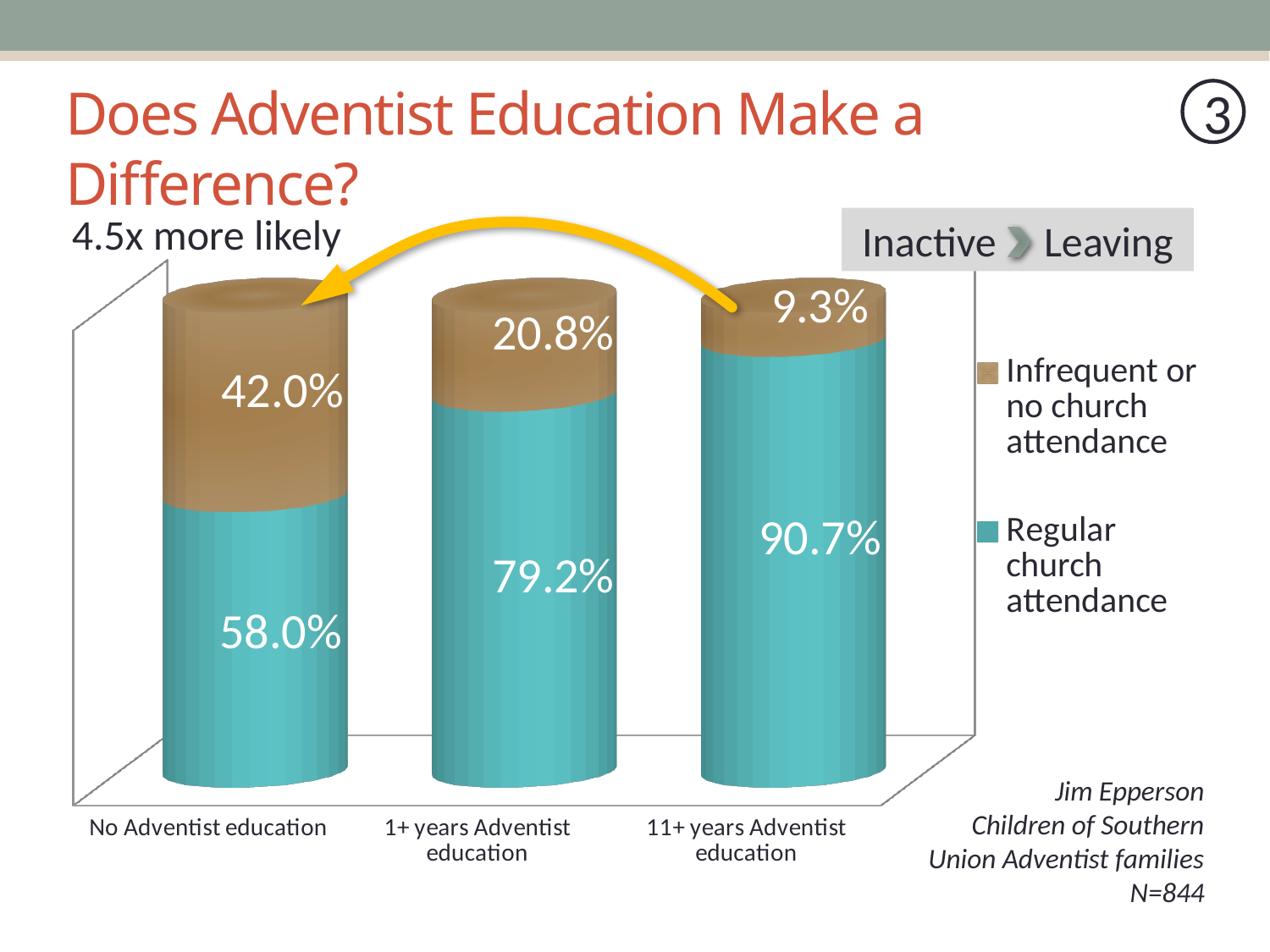
Which is larger: the Regular church attendance value for No Adventist education or for 1+ years Adventist education? 1+ years Adventist education What is the difference between the Infrequent or no church attendance values for No Adventist education and 11+ years Adventist education? 32.7% What is the value for Regular church attendance for the No Adventist education category? 58.0% What is the value for Regular church attendance for the 1+ years Adventist education category? 79.2% How many categories are shown on the x axis? 3 How many series does the legend list? 2 Which category has the highest value for Regular church attendance? 11+ years Adventist education Do the Regular church attendance values rise or fall from left to right along the x axis? Rise What kind of chart is shown on the slide? Stacked bar chart What is the value for Infrequent or no church attendance for the 11+ years Adventist education category? 9.3% Which category has the lowest value for Infrequent or no church attendance? 11+ years Adventist education What is the value for Infrequent or no church attendance for the 1+ years Adventist education category? 20.8%